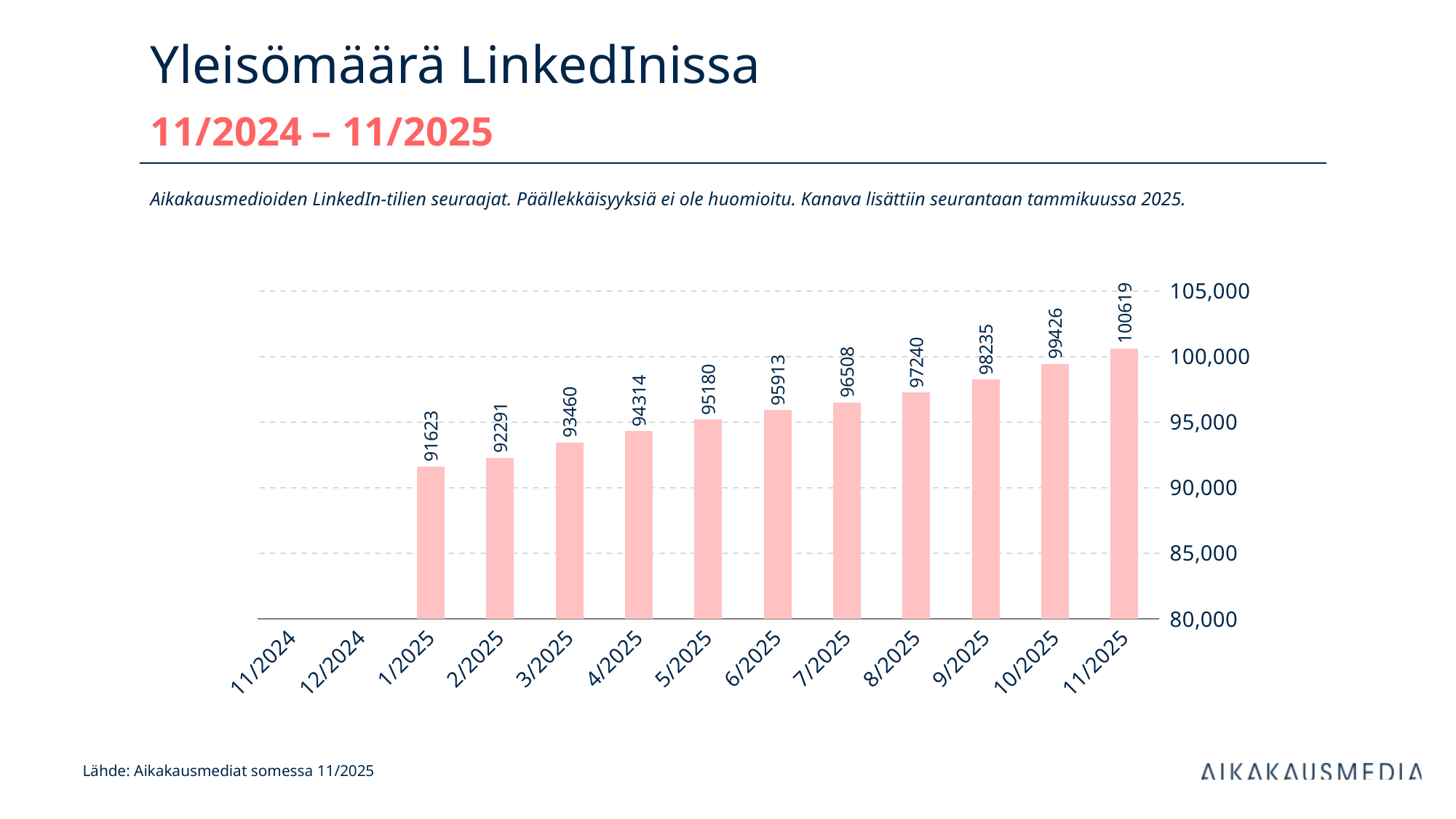
Is the value for 5/2025 greater or less than 95,000? greater What is the value for 6/2025? 95913 What kind of chart is shown? bar chart Which month has the highest value? 11/2025 What is the value for 1/2025? 91623 What is the difference between the values for 11/2025 and 1/2025? 8996 Do the values rise or fall from 1/2025 to 11/2025? rise Which month with a bar has the lowest value? 1/2025 What is the value for 11/2025? 100619 Which is larger, the value for 3/2025 or the value for 8/2025? 8/2025 What is the difference between the values for 10/2025 and 9/2025? 1191 How many months are labelled on the x axis? 13